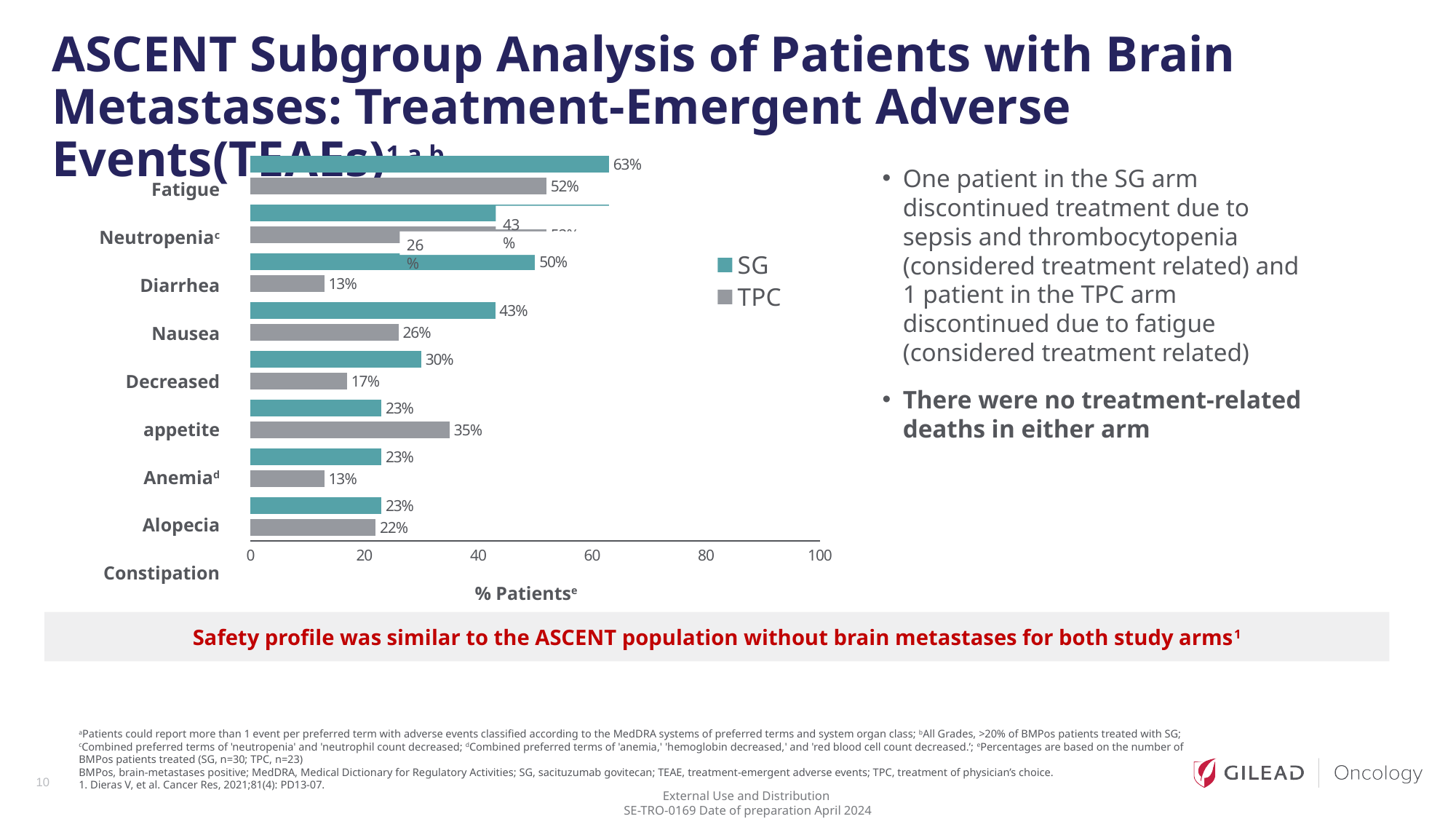
What is the difference between the SG and TPC values for Fatigue? 11% What is the SG value for Fatigue? 63% What is the TPC value for Fatigue? 52% How many series does the chart legend list? 2 What are the two series named in the chart legend? SG and TPC For Nausea, which series has the larger value, SG or TPC? SG What is the x-axis title of the chart? % Patients What is the SG value for Diarrhea? 50% What type of chart is shown on the slide? bar chart Is the SG value for Fatigue greater or less than 60? greater Which adverse event has the highest SG value? Fatigue What is the TPC value for Diarrhea? 13%